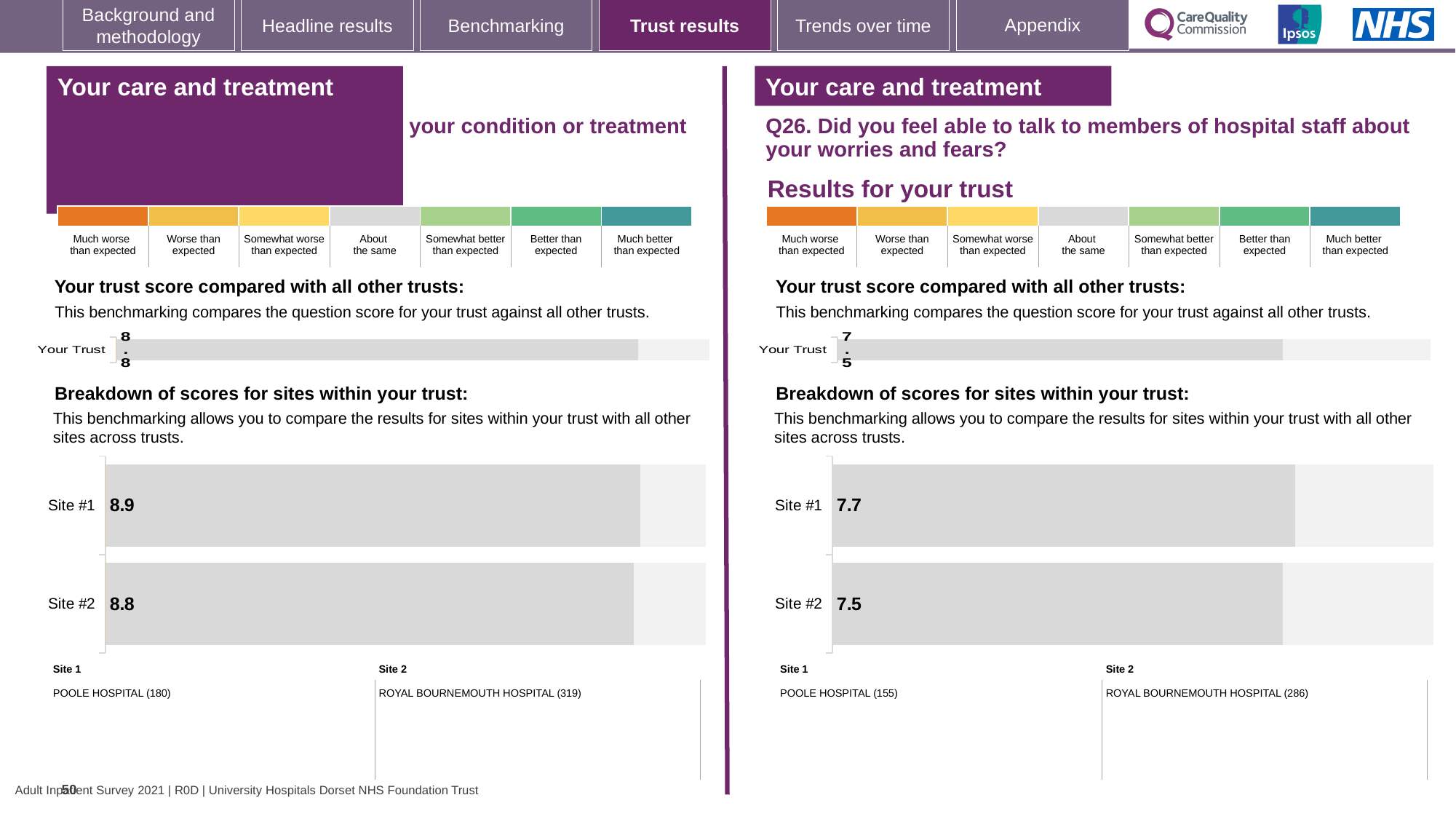
In the right-hand (Q26) site breakdown chart, which site has the higher score? Site #1 On the left-hand side of the slide, what is the 'Your Trust' score in the chart comparing the trust with all other trusts? 8.8 Is the Site #1 score in the left-hand site breakdown chart larger or smaller than the Site #1 score in the right-hand (Q26) site breakdown chart? Larger What type of chart is used for the site breakdown on the left-hand side of the slide? Bar chart On the left-hand side of the slide, what is the score shown for Site #1 in the breakdown of scores for sites within your trust? 8.9 In the left-hand site breakdown chart, what is the difference between the Site #1 and Site #2 scores? 0.1 On the right-hand side of the slide (Q26), what is the 'Your Trust' score in the chart comparing the trust with all other trusts? 7.5 How many sites are shown in the right-hand (Q26) site breakdown chart? 2 On the right-hand side of the slide (Q26), what is the score shown for Site #2 in the breakdown of scores for sites within your trust? 7.5 On the right-hand side of the slide (Q26), what is the score shown for Site #1 in the breakdown of scores for sites within your trust? 7.7 On the left-hand side of the slide, what is the score shown for Site #2 in the breakdown of scores for sites within your trust? 8.8 In the right-hand (Q26) site breakdown chart, what is the difference between the Site #1 and Site #2 scores? 0.2